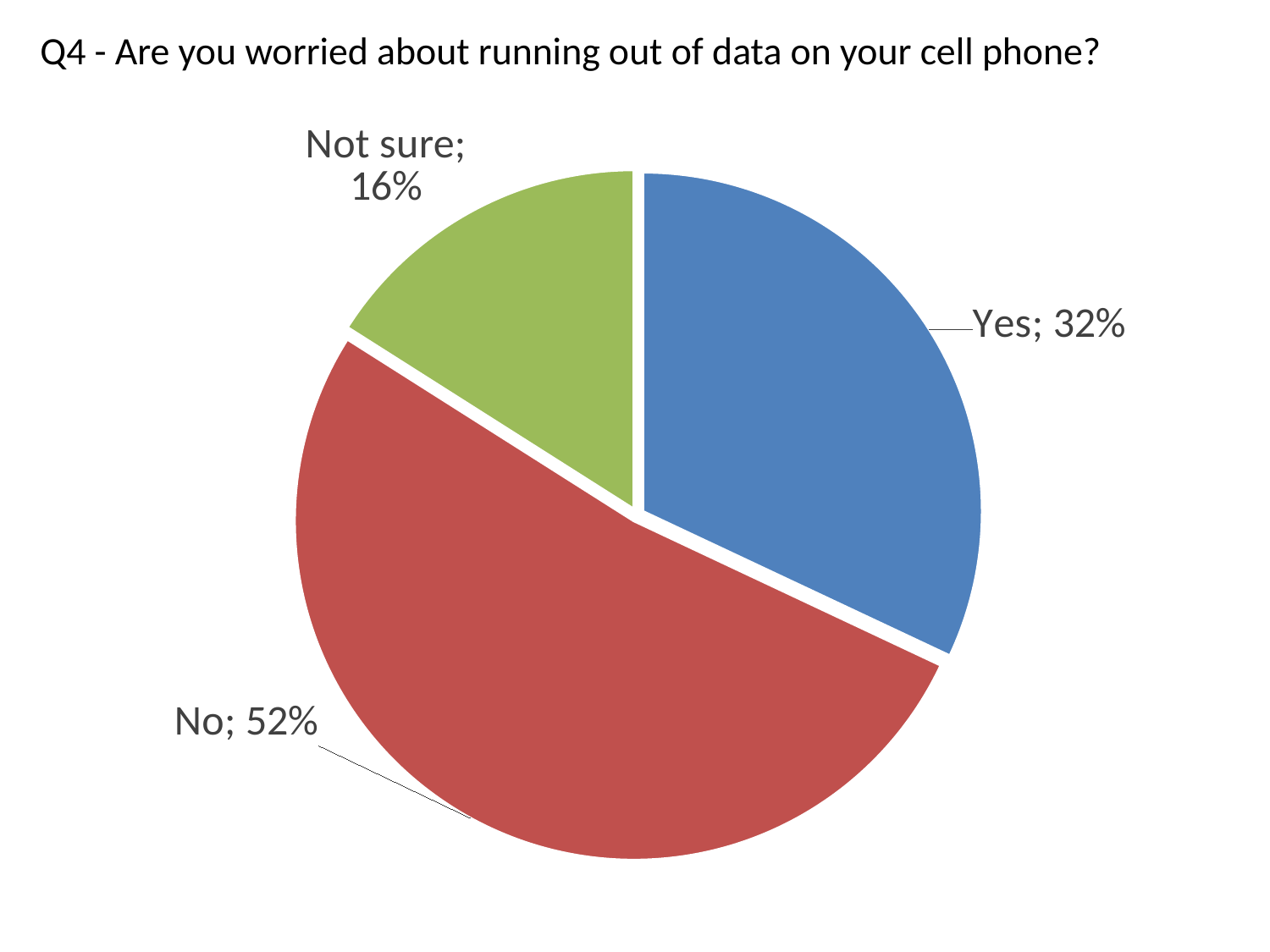
What colour is the "No" slice? red Which is larger, the share for "Yes" or the share for "Not sure"? Yes What type of chart is shown on the slide? pie chart How many slices does the pie chart have? 3 What percentage of respondents answered "Yes"? 32% What is the difference in percentage points between "No" and "Yes"? 20 Which response has the smallest share of the pie? Not sure Which response has the largest share of the pie? No What percentage of respondents answered "Not sure"? 16% What is the difference in percentage points between "Yes" and "Not sure"? 16 What percentage of respondents answered "No"? 52% What is the title of the chart? Q4 - Are you worried about running out of data on your cell phone?